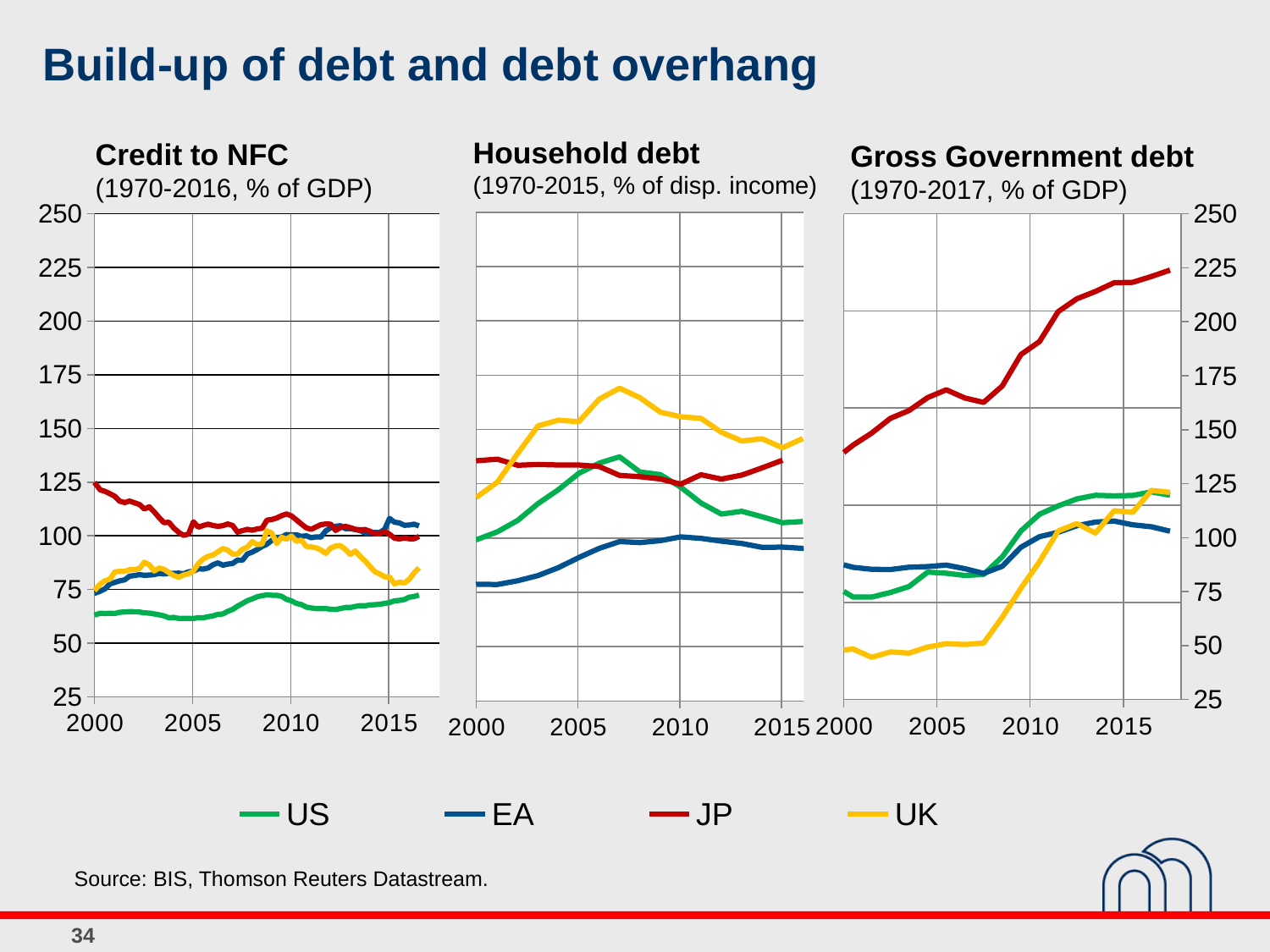
How many series does the legend list for the charts on this slide? 4 In the 'Household debt' chart, which is larger in 2015, US or EA? US What kind of chart is the 'Credit to NFC' chart? line chart In the 'Gross Government debt' chart, which series is highest in 2017? JP In the 'Gross Government debt' chart, is the value for JP in 2017 greater or less than 200? greater In the 'Credit to NFC' chart, does the JP line rise or fall between 2000 and 2005? falls In the 'Gross Government debt' chart, does the UK line rise or fall between 2008 and 2012? rises In the 'Household debt' chart, which series is highest in 2007? UK In the 'Credit to NFC' chart, which series is lowest in 2015? US In the 'Household debt' chart, is the value for UK in 2007 greater or less than 150? greater In the 'Household debt' chart, is the value for EA in 2000 greater or less than 100? less